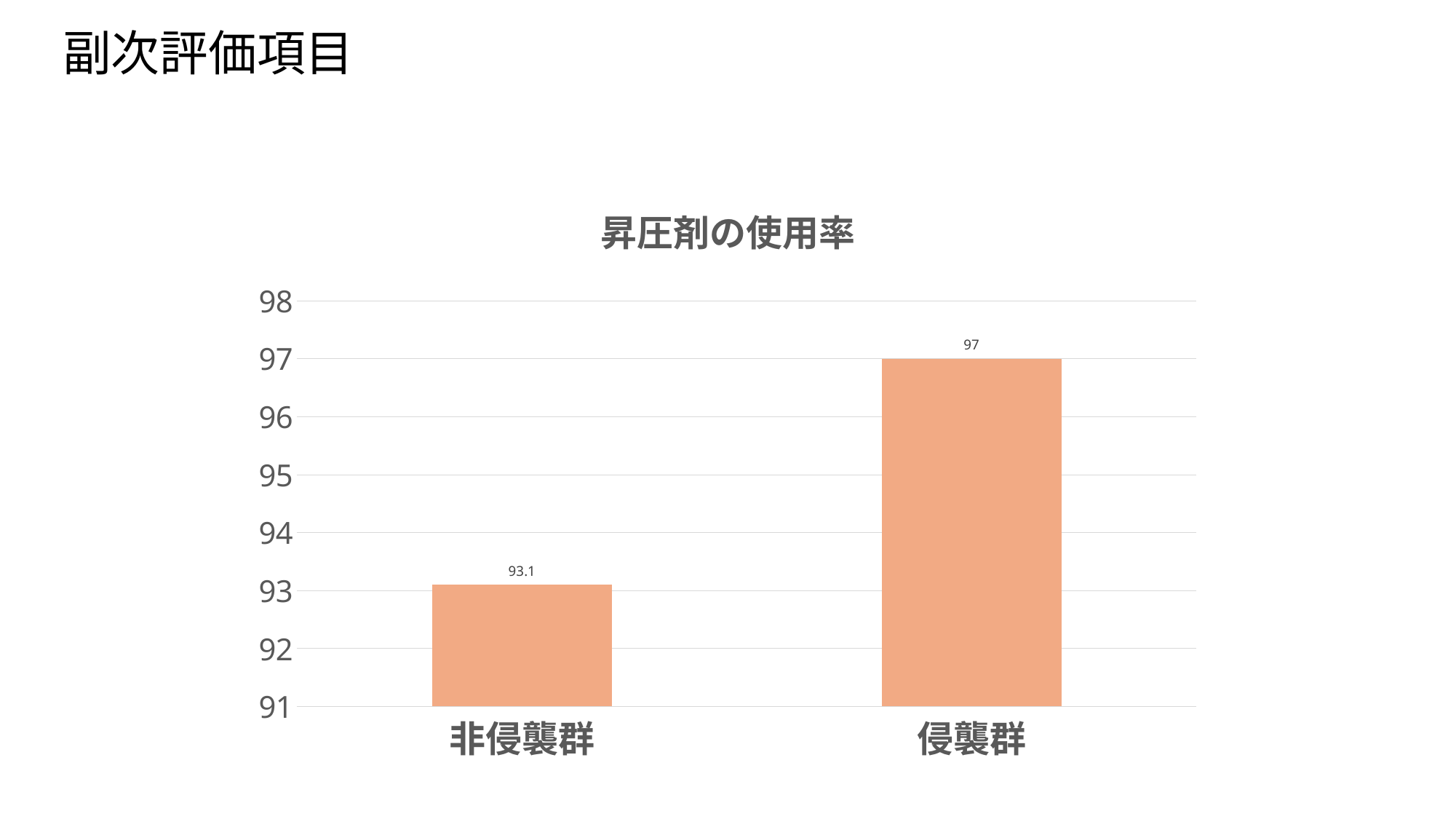
Which category has the lowest value? 非侵襲群 What is the value for 侵襲群? 97 Is the value for 非侵襲群 greater or less than 94? less Which category has the highest value? 侵襲群 What kind of chart is shown on the slide? bar chart How many categories are shown on the x axis? 2 What is the lowest value shown on the vertical axis? 91 What is the title of the chart? 昇圧剤の使用率 What is the difference between the values for 侵襲群 and 非侵襲群? 3.9 Which is larger, the value for 非侵襲群 or the value for 侵襲群? 侵襲群 What is the value for 非侵襲群? 93.1 Is the value for 侵襲群 greater or less than 96? greater